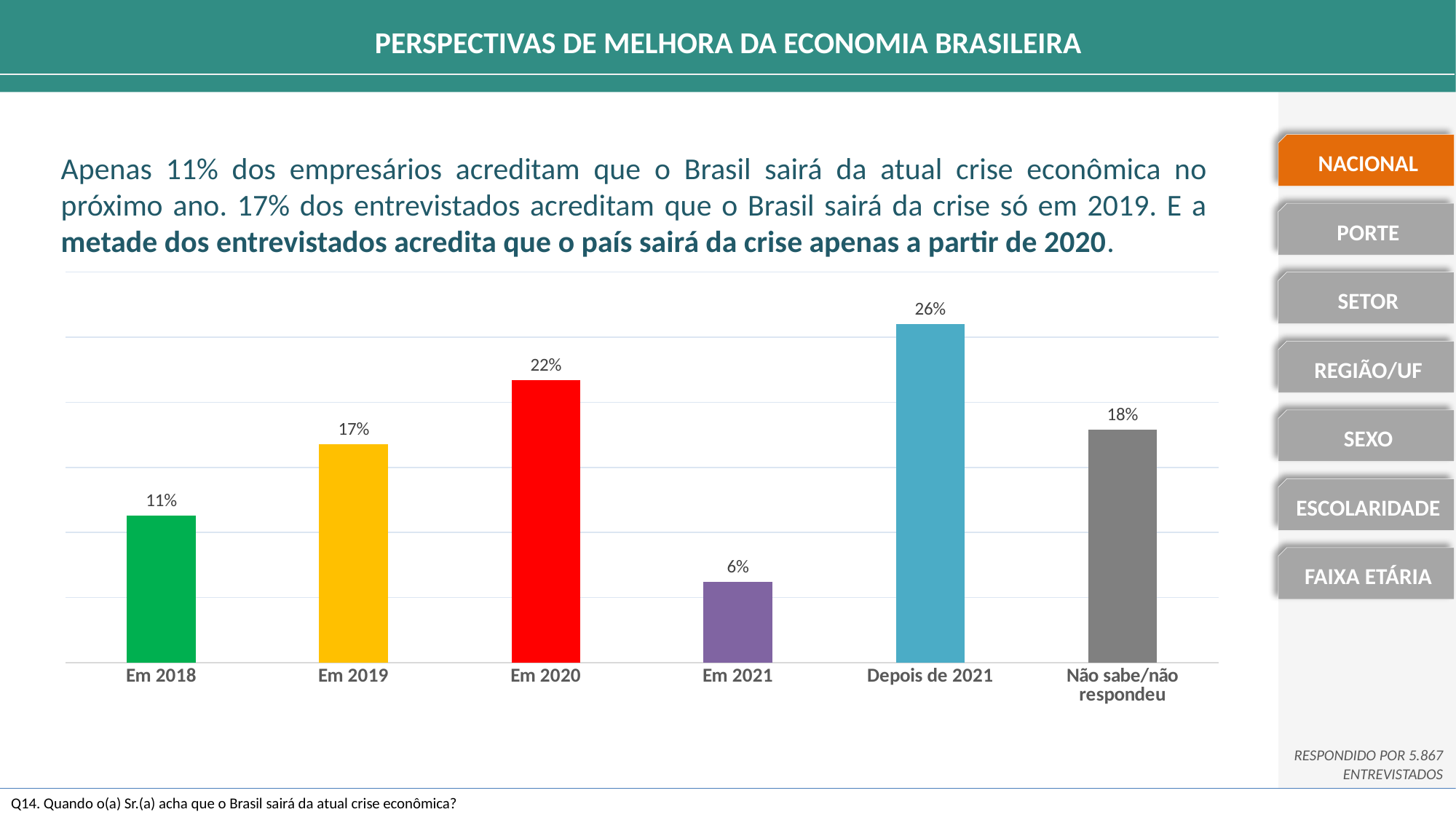
Which category has the highest value? Depois de 2021 What kind of chart is shown on the slide? Bar chart What is the value for Não sabe/não respondeu? 18% How many categories are shown on the x axis? 6 What is the difference between the values for Depois de 2021 and Em 2019? 9% What colour is the bar for Em 2020? Red Which is larger, the value for Em 2019 or the value for Não sabe/não respondeu? Não sabe/não respondeu What is the title of the slide containing the chart? PERSPECTIVAS DE MELHORA DA ECONOMIA BRASILEIRA Which category has the lowest value? Em 2021 What is the difference between the values for Em 2020 and Em 2021? 16% What is the value for Em 2018? 11% What is the value for Em 2020? 22%